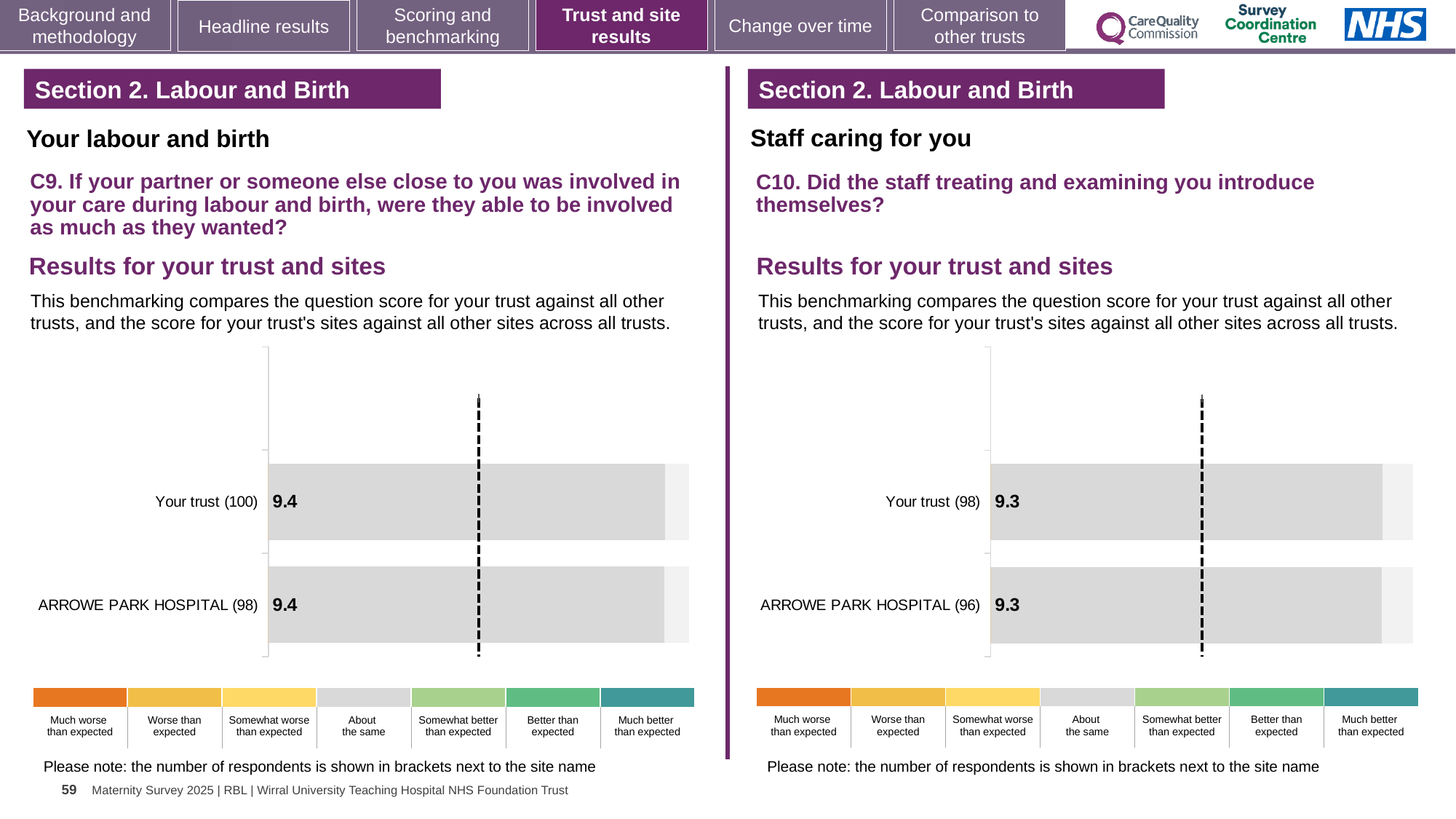
What kind of chart is used on the left (C9) to show the results for your trust and sites? Bar chart Is the score for Your trust on the left chart (C9) larger than, smaller than, or equal to the score for Your trust on the right chart (C10)? Larger On the right chart (C10), what is the score for ARROWE PARK HOSPITAL (96)? 9.3 On the right chart (C10), what is the score for Your trust (98)? 9.3 How many bars are plotted on the right chart (C10)? 2 How many bars are plotted on the left chart (C9)? 2 On the left chart (C9), what is the score for ARROWE PARK HOSPITAL (98)? 9.4 On the left chart (C9), what is the score for Your trust (100)? 9.4 On the right chart (C10), what is the difference between the score for Your trust and the score for ARROWE PARK HOSPITAL? 0.0 On the left chart (C9), what is the difference between the score for Your trust and the score for ARROWE PARK HOSPITAL? 0.0 On the right chart (C10), how many respondents are shown in brackets for ARROWE PARK HOSPITAL? 96 On the left chart (C9), which benchmark category does the grey colour of the bars correspond to in the legend? About the same